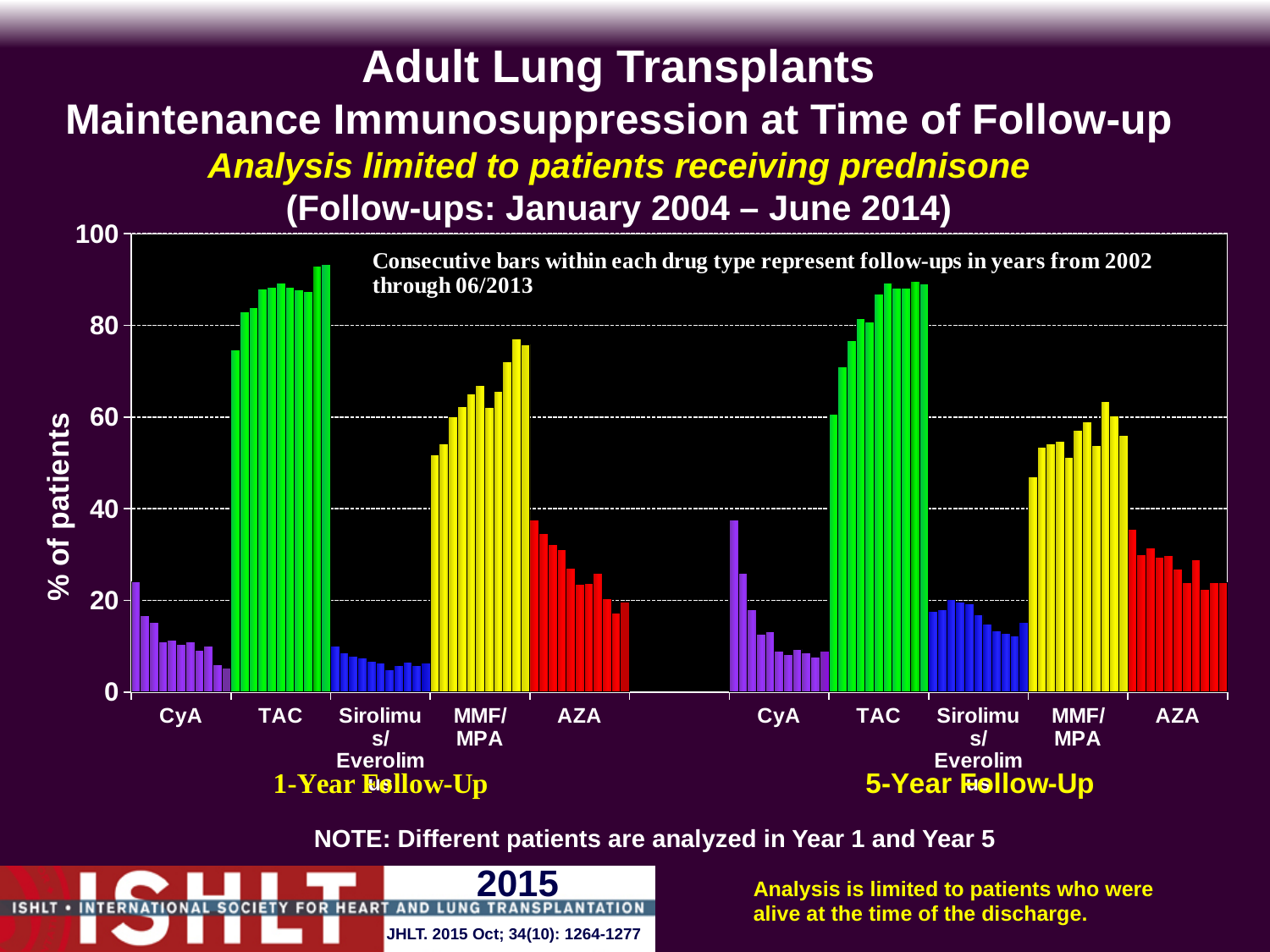
In the 5-Year Follow-Up panel, are the Sirolimus/Everolimus bars greater or less than 40? less In the 1-Year Follow-Up panel, which drug type has the highest percentage of patients? TAC In the 5-Year Follow-Up panel, which drug type has the highest percentage of patients? TAC In the 1-Year Follow-Up panel, are the TAC bars greater or less than 60? greater In the 1-Year Follow-Up panel, do the CyA values rise or fall across the consecutive follow-up years? fall In the 1-Year Follow-Up panel, do the TAC values rise or fall across the consecutive follow-up years? rise In the 1-Year Follow-Up panel, which drug type has the lowest percentage of patients? Sirolimus/Everolimus What kind of chart is shown on the slide? bar chart According to the note inside the chart, which follow-up years do the consecutive bars within each drug type represent? 2002 through 06/2013 In the 1-Year Follow-Up panel, are the AZA bars greater or less than 40? less What is the label of the y axis? % of patients How many drug types are shown in the 1-Year Follow-Up panel? 5